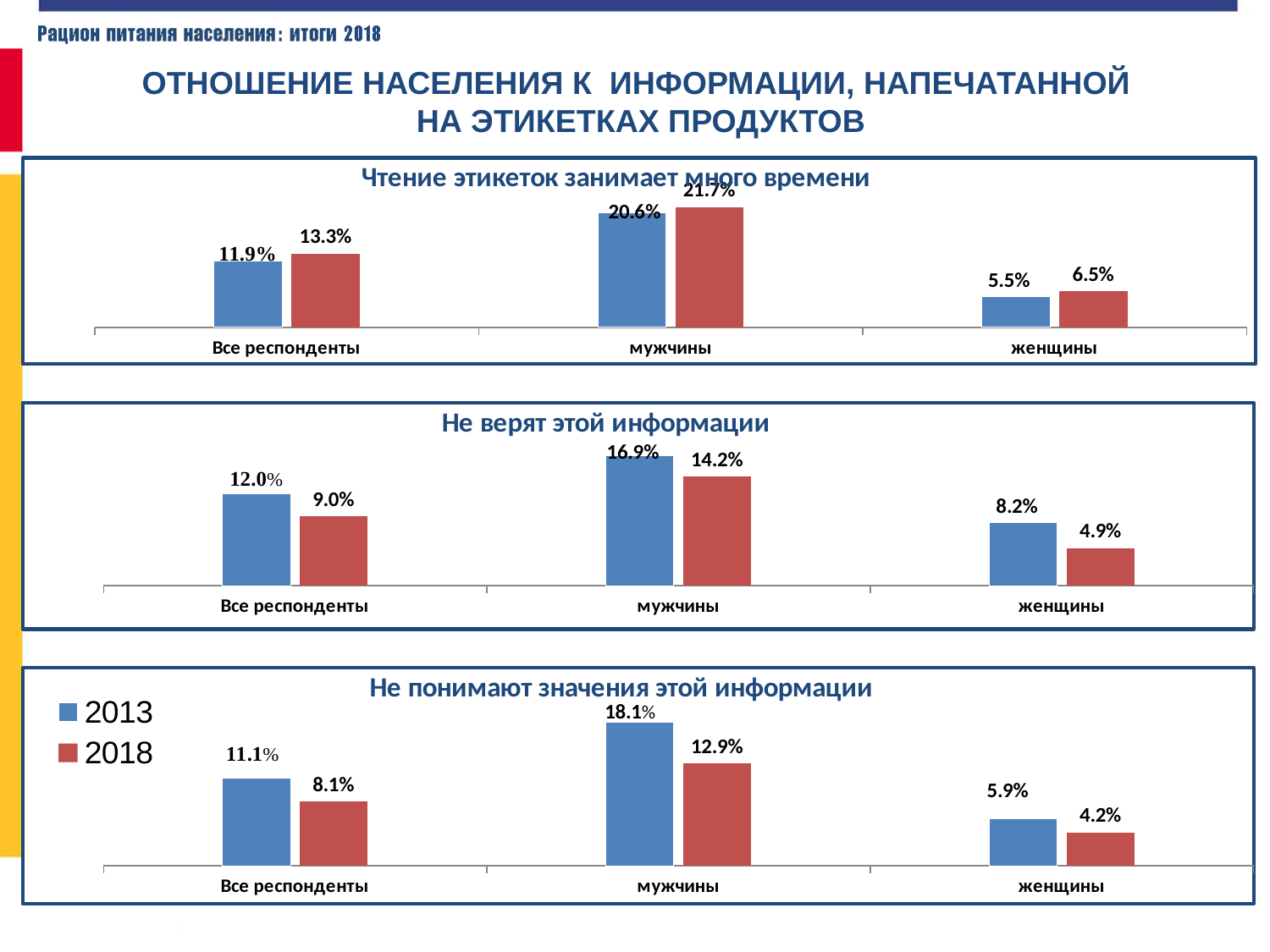
How many categories are shown on the x axis of the chart 'Чтение этикеток занимает много времени'? 3 In the chart 'Не верят этой информации', which is larger for женщины: the 2013 value or the 2018 value? 2013 In the chart 'Чтение этикеток занимает много времени', what is the value for женщины in 2013? 5.5% In the chart 'Не верят этой информации', what is the value for Все респонденты in 2018? 9.0% In the chart 'Чтение этикеток занимает много времени', which category has the highest 2018 value? мужчины In the chart 'Не понимают значения этой информации', what is the difference between the 2013 and 2018 values for Все респонденты? 3.0% In the chart 'Не верят этой информации', what is the difference between the 2013 and 2018 values for мужчины? 2.7% In the chart 'Не понимают значения этой информации', which category has the lowest 2018 value? женщины In the chart 'Не понимают значения этой информации', what is the value for мужчины in 2013? 18.1% In the chart 'Чтение этикеток занимает много времени', what is the value for мужчины in 2018? 21.7% How many series does the legend on the slide list? 2 What type of chart is 'Не верят этой информации'? bar chart